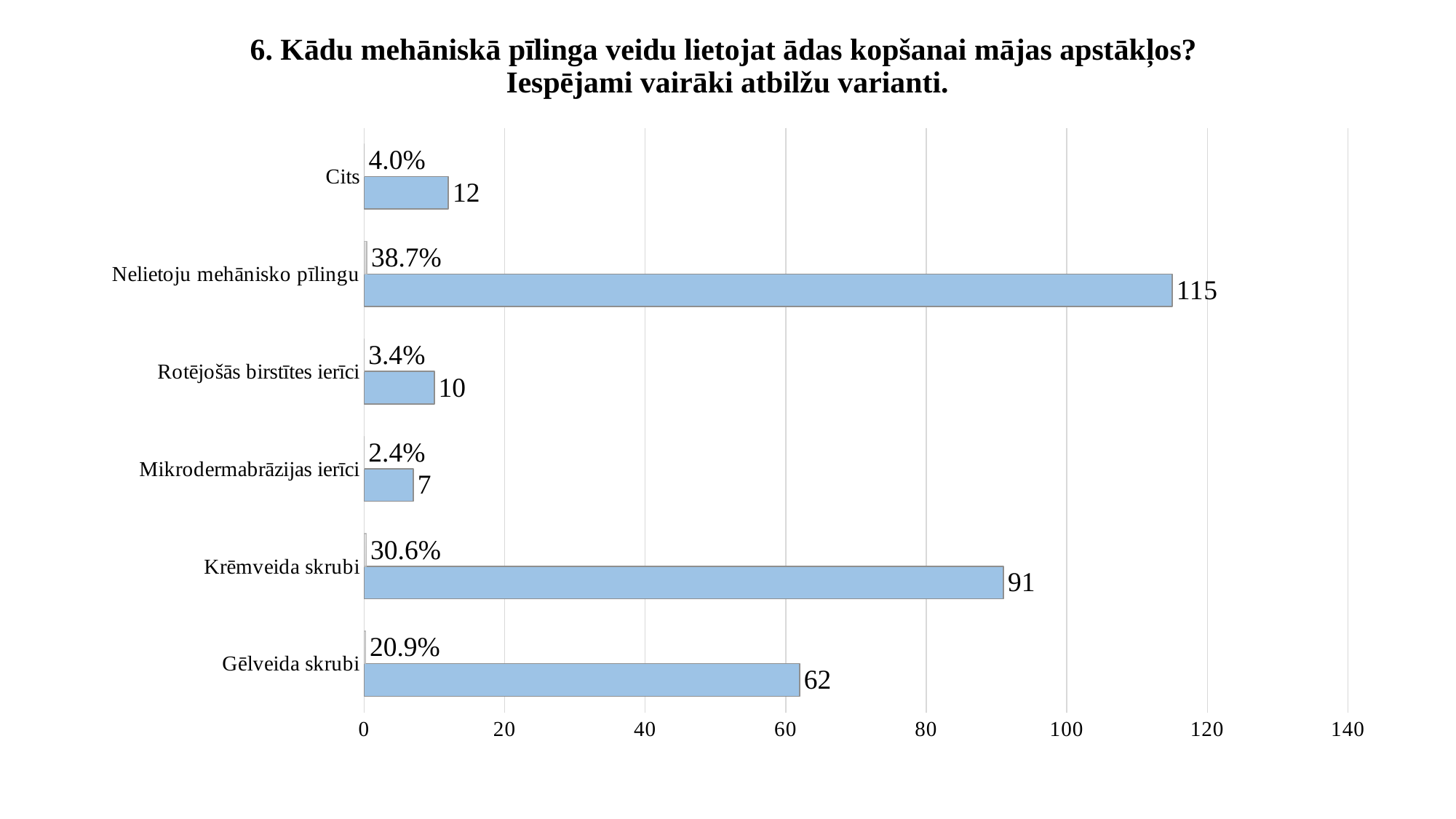
Which category has the highest count? Nelietoju mehānisko pīlingu Which category has the lowest count? Mikrodermabrāzijas ierīci What is the count value for Gēlveida skrubi? 62 What percentage is shown for Krēmveida skrubi? 30.6% What kind of chart is shown on the slide? Bar chart What is the difference between the counts for Krēmveida skrubi and Gēlveida skrubi? 29 Which has a larger count, Cits or Rotējošās birstītes ierīci? Cits What is the count value for Nelietoju mehānisko pīlingu? 115 Is the count for Nelietoju mehānisko pīlingu greater or less than 100? greater What is the highest value shown on the horizontal axis? 140 How many categories are shown on the chart? 6 What percentage is shown for Mikrodermabrāzijas ierīci? 2.4%